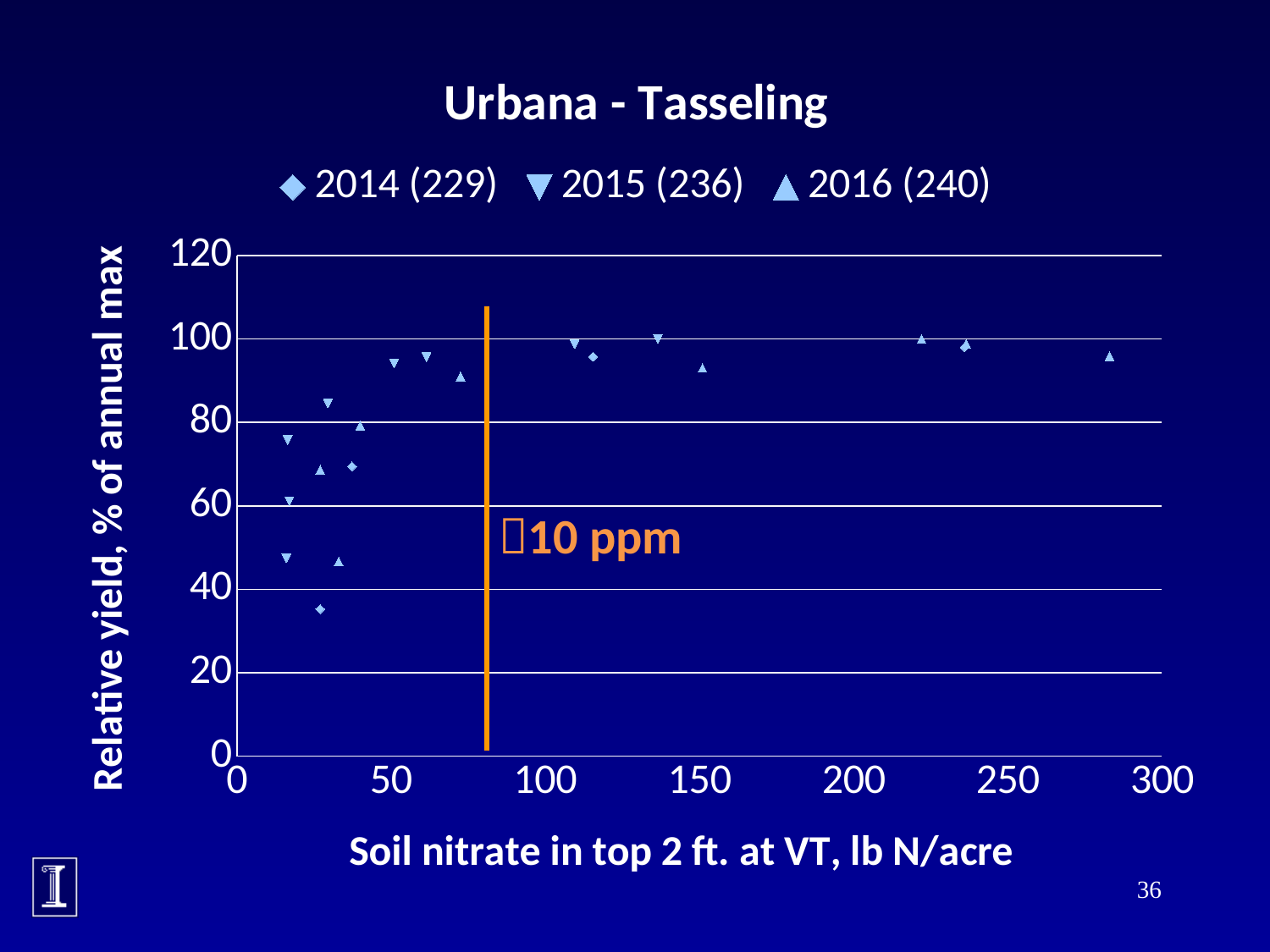
Do relative yield values generally rise or fall as soil nitrate increases from 0 to about 100 lb N/acre? rise Which series has the lowest plotted point on the chart? 2014 (229) What is the maximum value shown on the y axis? 120 What is the title of the chart? Urbana - Tasseling How many series does the legend list? 3 Is the lowest plotted value for the 2014 (229) series greater or less than 40? less Are all points to the right of the orange vertical line above or below 80 on the y axis? above Which series is plotted with diamond markers? 2014 (229) Is the relative yield of the 2016 (240) point with the highest soil nitrate (near 280 lb N/acre) greater or less than 80? greater What kind of chart is shown on the slide? scatter chart